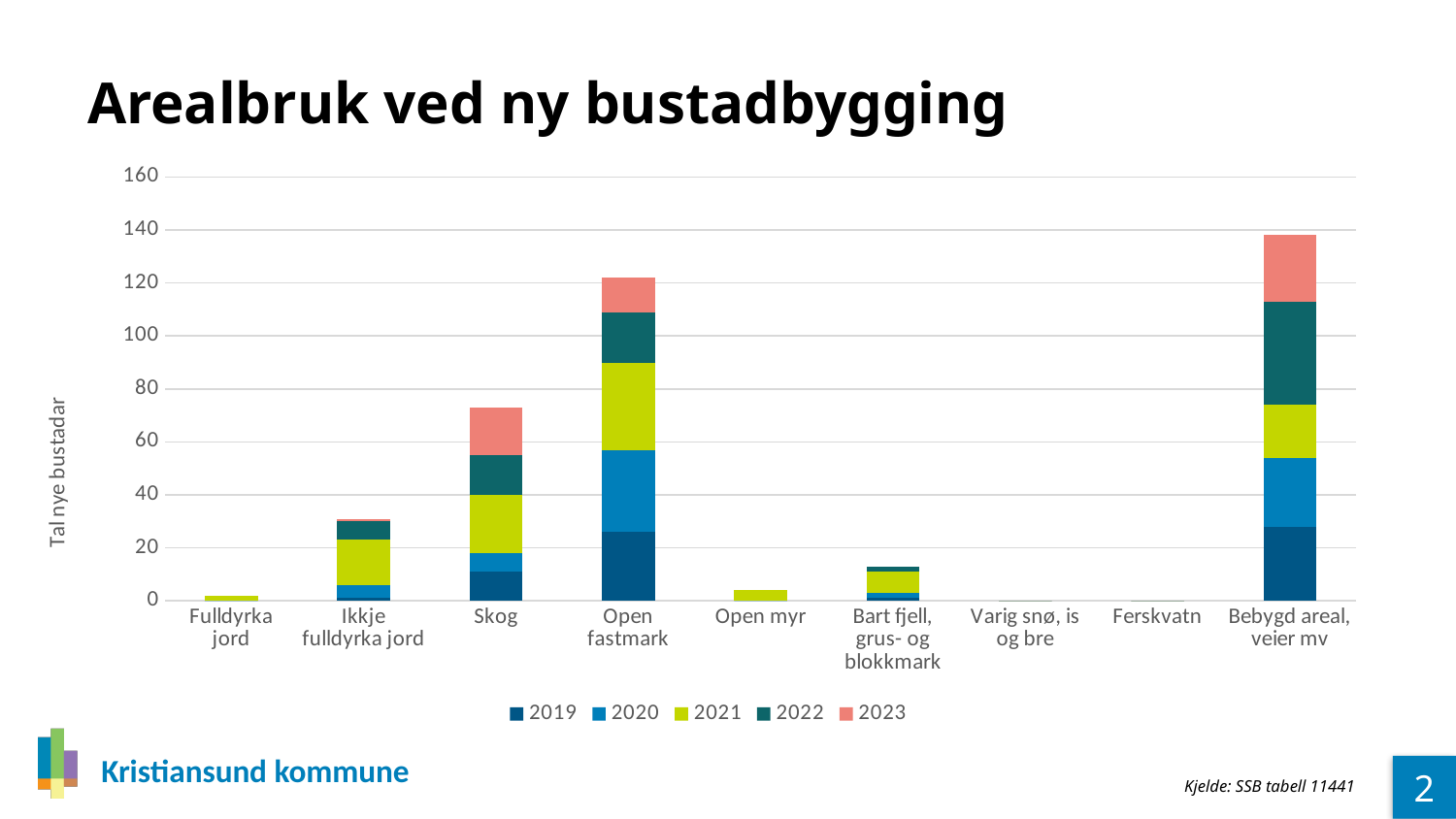
What is the title of the chart on the slide? Arealbruk ved ny bustadbygging What is the label on the y axis of the chart? Tal nye bustadar How many series does the legend list? 5 Is the total value for Open fastmark greater or less than 100? greater Is the total value for Skog greater or less than 80? less What kind of chart is shown on the slide? Stacked bar chart Which category has the highest total stacked bar? Bebygd areal, veier mv Is the total value for Ikkje fulldyrka jord greater or less than 40? less Which has the larger total stacked bar, Bebygd areal, veier mv or Open fastmark? Bebygd areal, veier mv Which has the larger total stacked bar, Open fastmark or Skog? Open fastmark How many categories are shown on the x axis of the chart? 9